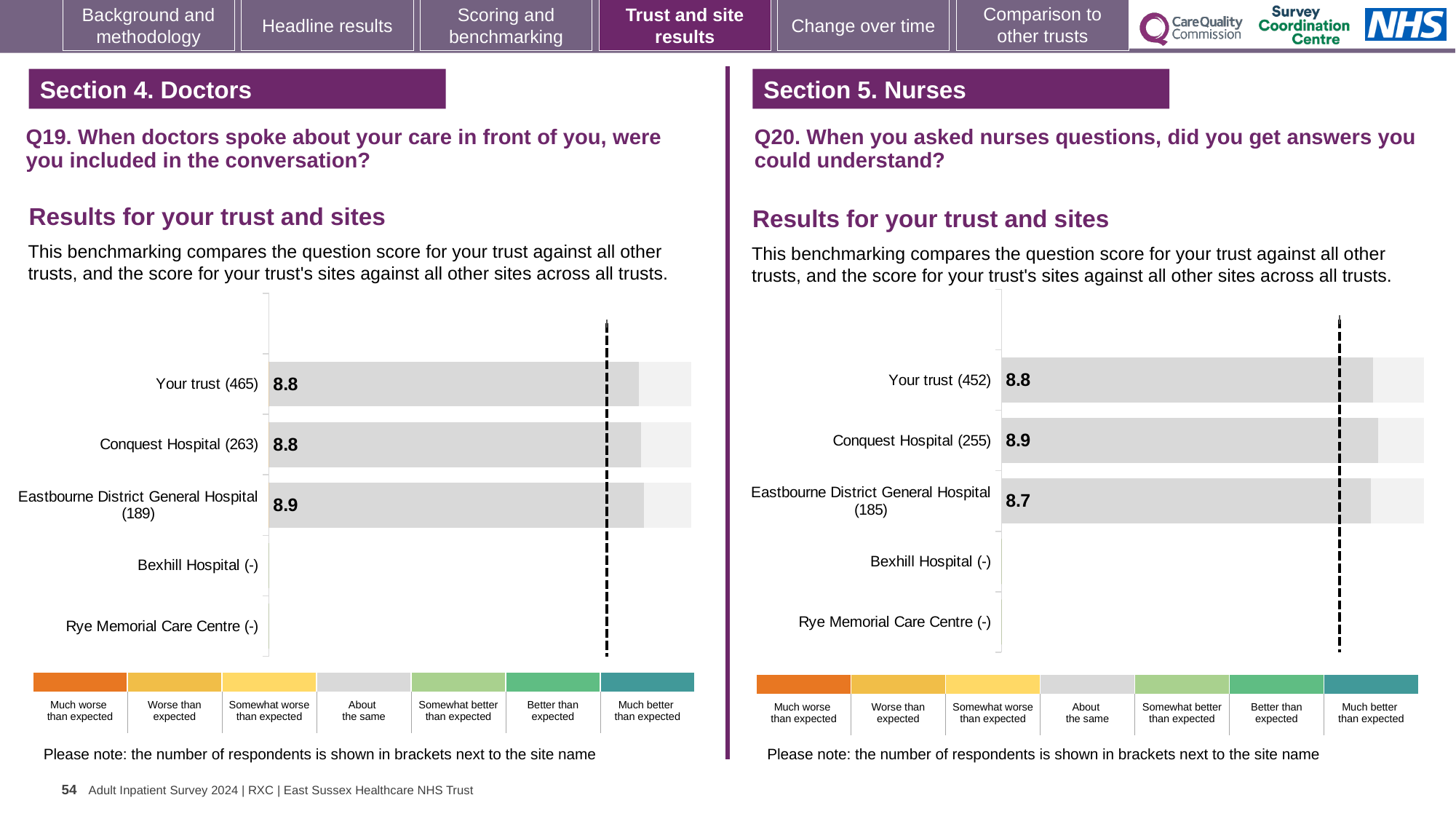
In the Q19 chart on the left, what is the score for Your trust (465)? 8.8 In the Q20 chart on the right, what is the difference between the scores for Conquest Hospital (255) and Eastbourne District General Hospital (185)? 0.2 In the Q19 chart on the left, how many sites have a score shown as a bar? 3 In the Q20 chart on the right, which site has the highest score? Conquest Hospital (255) What type of chart is used in the Q20 chart on the right? bar chart In the Q19 chart on the left, is the score for Eastbourne District General Hospital (189) higher or lower than the score for Your trust (465)? higher In the Q19 chart on the left, how many respondents are shown for Conquest Hospital? 263 In the Q20 chart on the right, what is the score for Eastbourne District General Hospital (185)? 8.7 In the Q20 chart on the right, what is the score for Conquest Hospital (255)? 8.9 In the Q19 chart on the left, which site has the highest score? Eastbourne District General Hospital (189) In the Q19 chart on the left, what is the score for Eastbourne District General Hospital (189)? 8.9 In the Q20 chart on the right, which site has the lowest score? Eastbourne District General Hospital (185)